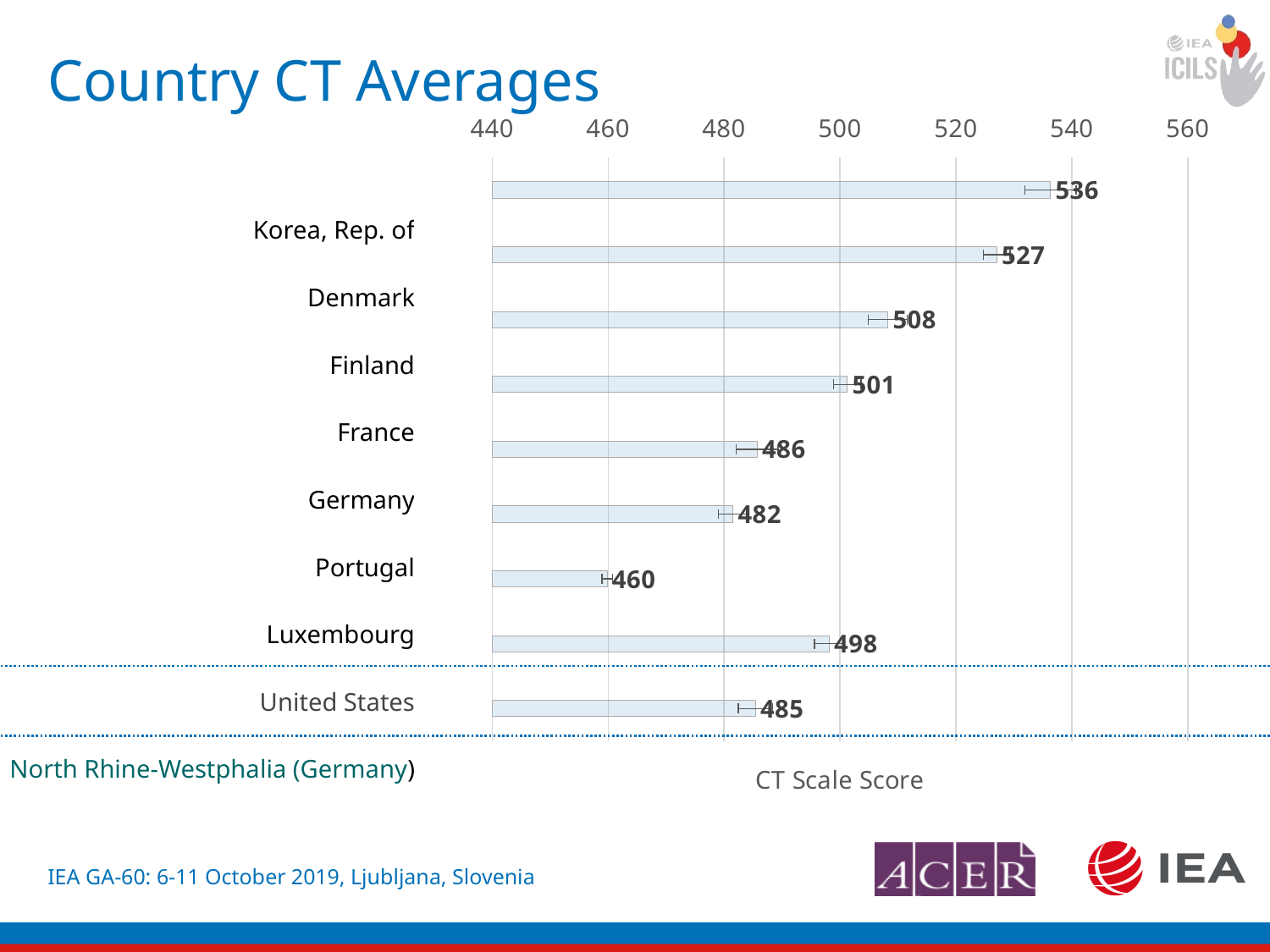
What is the title of the chart? Country CT Averages What is the difference between the highest bar value (536) and the lowest bar value (460)? 76 What kind of chart is shown on the slide? bar chart What is the lowest value shown on any bar in the chart? 460 Is the value of the longest bar greater or less than 520? greater How many bars are plotted in the chart? 9 What is the label on the horizontal axis of the chart? CT Scale Score What is the difference between the bar labelled 508 and the bar labelled 501? 7 How many bars have a value greater than 500? 4 How many bars have a value less than 480? 1 What is the second-highest value labelled on a bar in the chart? 527 What is the highest value shown on any bar in the chart? 536